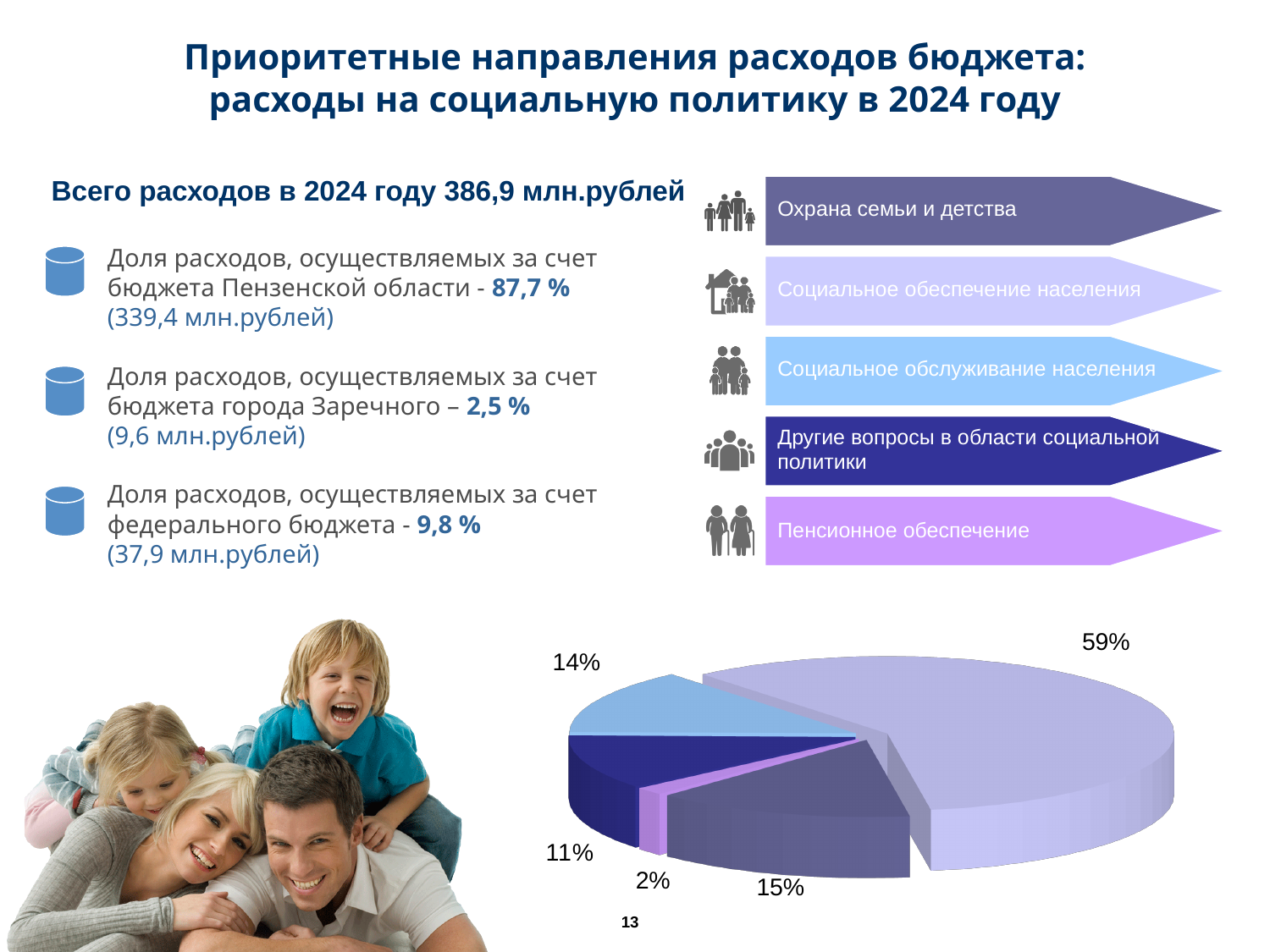
What is the largest share shown in the pie chart? 59% Which is larger in the pie chart: the 14% slice or the 11% slice? 14% How many slices does the pie chart have? 5 What is the difference between the largest slice (59%) and the 15% slice in the pie chart? 44% What kind of chart is shown at the bottom right of the slide? pie chart What share does the light blue slice of the pie chart represent? 14% What is the combined share of the 14% and 11% slices in the pie chart? 25% What is the smallest share shown in the pie chart? 2% How many categories are listed in the legend to the right of the slide? 5 Which category in the legend corresponds to the light lavender colour of the 59% slice? Социальное обеспечение населения What share does the dark blue slice of the pie chart represent? 11% What share does the slate-purple slice labelled next to 15% represent? 15%